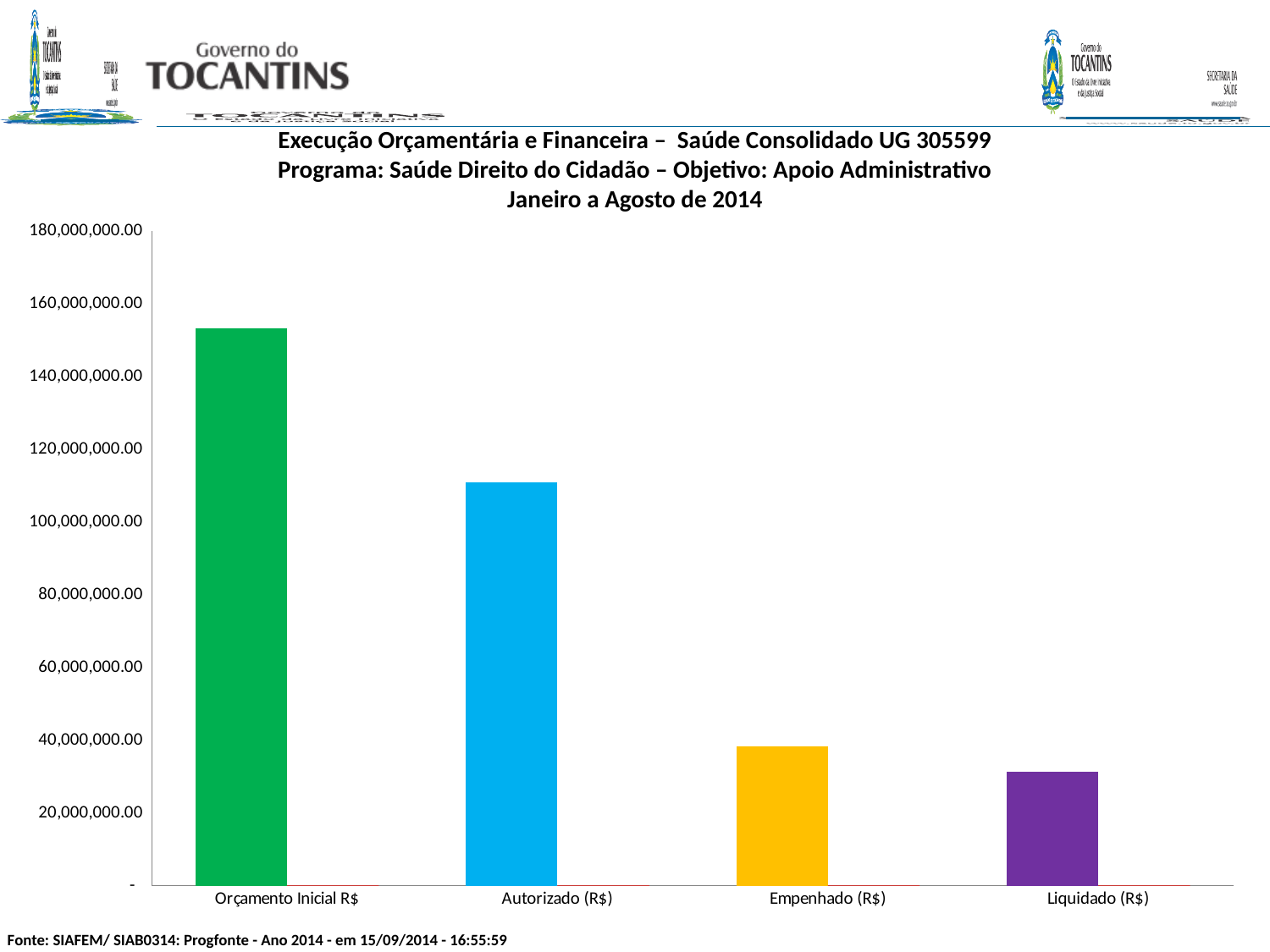
What kind of chart is shown on the slide? bar chart What colour is the bar for Empenhado (R$)? yellow Do the values rise or fall from left to right across the categories? fall Is the value for Orçamento Inicial R$ greater or less than 140,000,000.00? greater How many categories are plotted on the chart? 4 Is the value for Autorizado (R$) greater or less than 100,000,000.00? greater Which category has the highest value? Orçamento Inicial R$ Which category has the lowest value? Liquidado (R$) Is the value for Empenhado (R$) greater or less than 60,000,000.00? less What period does the chart title say the data covers? Janeiro a Agosto de 2014 Which is larger, the value for Autorizado (R$) or the value for Empenhado (R$)? Autorizado (R$)